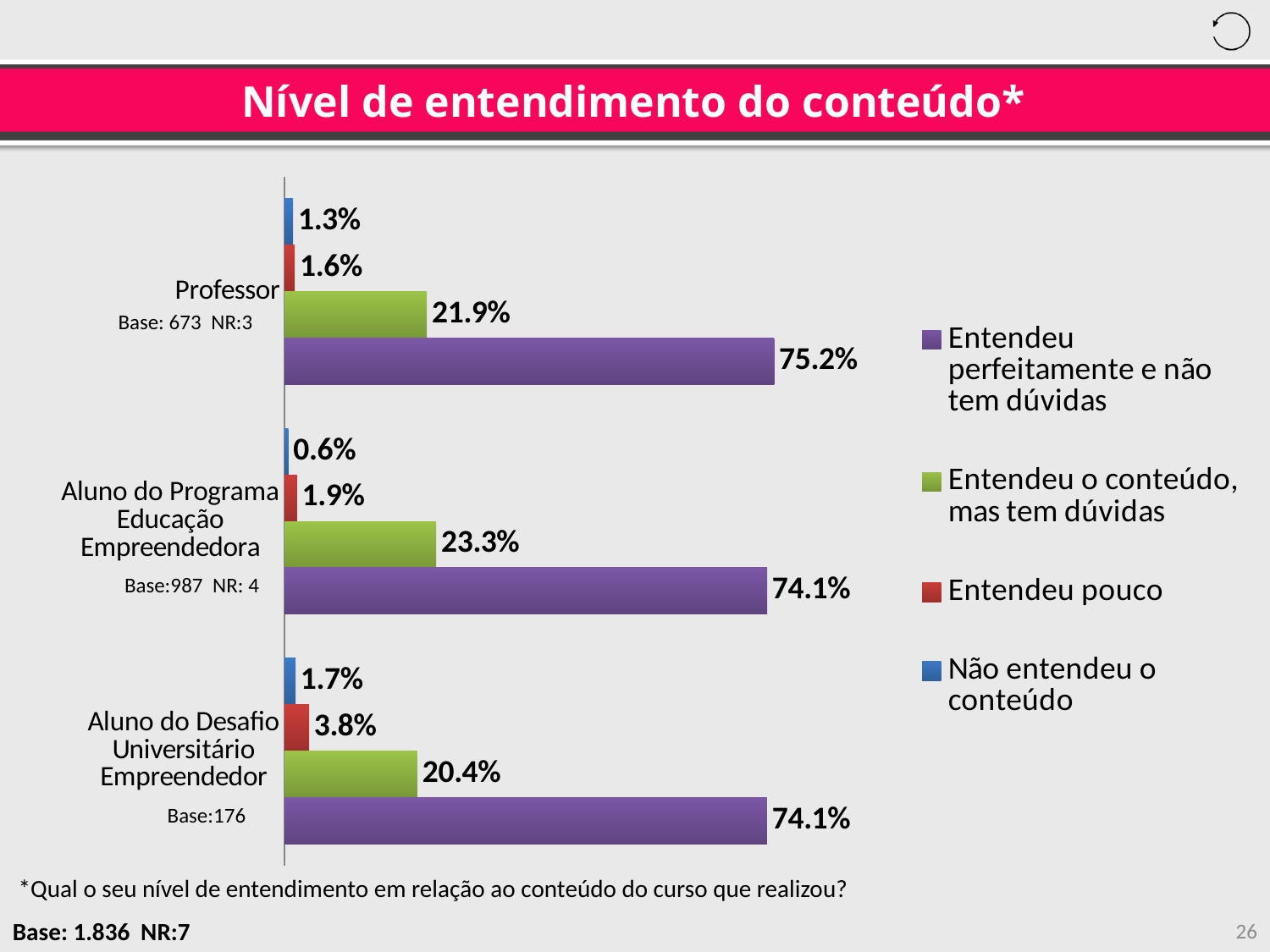
Which category has the lowest value for "Entendeu o conteúdo, mas tem dúvidas"? Aluno do Desafio Universitário Empreendedor What is the difference between the "Entendeu o conteúdo, mas tem dúvidas" values for Aluno do Programa Educação Empreendedora and Professor? 1.4% What is the value for "Não entendeu o conteúdo" among Aluno do Programa Educação Empreendedora? 0.6% Which colour represents "Entendeu pouco" in the legend? Red What is the value for "Entendeu pouco" among Aluno do Desafio Universitário Empreendedor? 3.8% What is the value for "Entendeu o conteúdo, mas tem dúvidas" among Aluno do Programa Educação Empreendedora? 23.3% What kind of chart is shown on the slide? Bar chart What percentage of Professor respondents answered "Entendeu perfeitamente e não tem dúvidas"? 75.2% Which is larger: the "Entendeu pouco" value for Professor or for Aluno do Desafio Universitário Empreendedor? Aluno do Desafio Universitário Empreendedor How many categories are shown on the chart? 3 Which category has the highest value for "Entendeu perfeitamente e não tem dúvidas"? Professor How many series does the legend list? 4